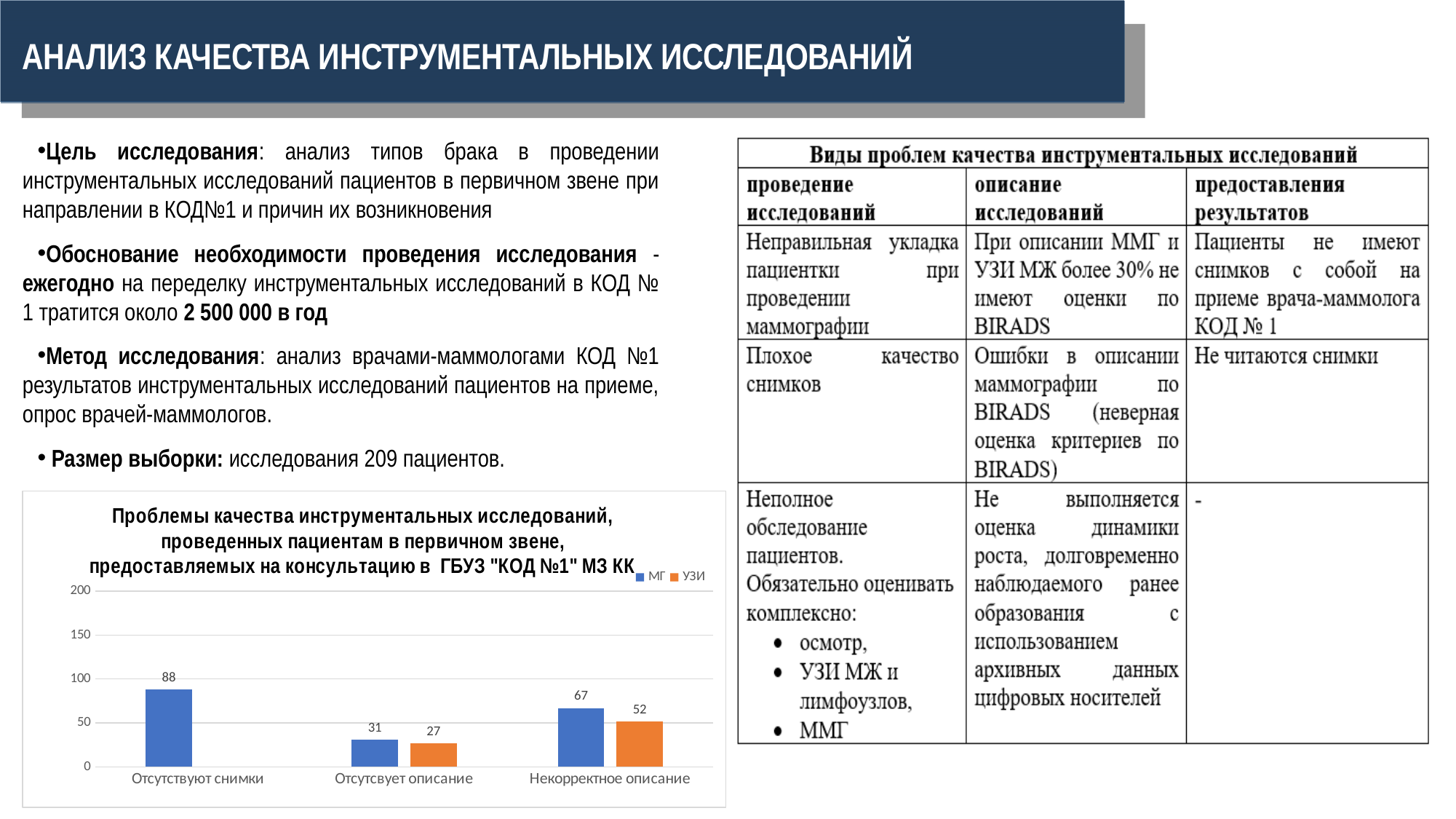
What is the value for МГ in the category "Отсутствуют снимки"? 88 What kind of chart is shown on the slide? Bar chart Which is larger in the category "Отсутсвует описание": the МГ value or the УЗИ value? МГ How many categories are shown on the x axis of the chart? 3 What is the difference between the МГ and УЗИ values in the category "Некорректное описание"? 15 What is the value for МГ in the category "Некорректное описание"? 67 Which category has the lowest value for the МГ series? Отсутсвует описание How many series does the chart legend list? 2 What is the value for УЗИ in the category "Отсутсвует описание"? 27 Is the value for МГ in "Отсутствуют снимки" greater or less than 50? greater Which category has the highest value for the МГ series? Отсутствуют снимки What is the value for УЗИ in the category "Некорректное описание"? 52